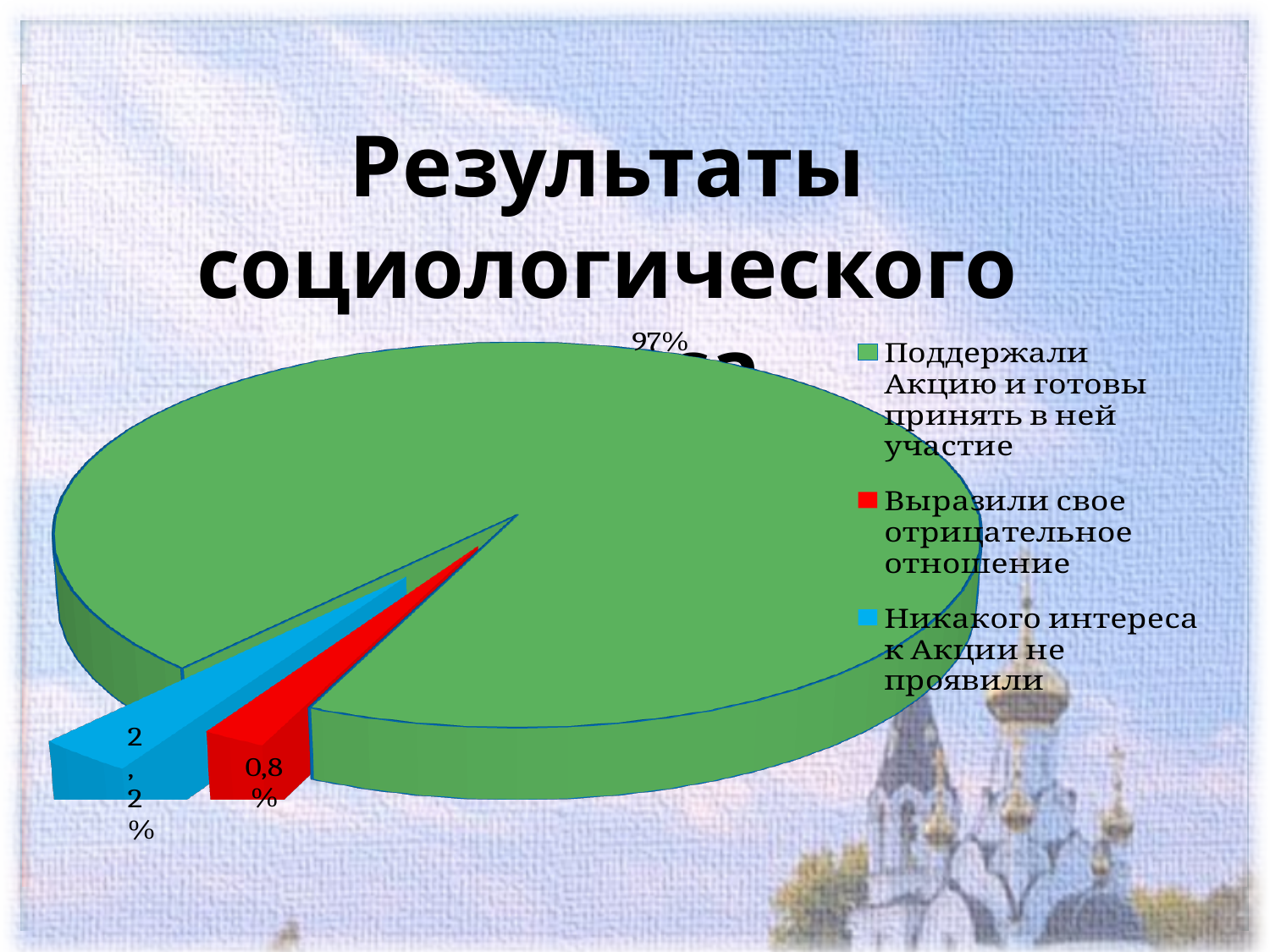
Which category has the largest share of the pie? Поддержали Акцию и готовы принять в ней участие What percentage of respondents supported the Action and are ready to take part in it (Поддержали Акцию и готовы принять в ней участие)? 97% What is the difference in percentage points between the largest slice (97%) and the slice for those who showed no interest (2,2%)? 94,8% How many entries does the legend list? 3 What percentage of respondents expressed a negative attitude (Выразили свое отрицательное отношение)? 0,8% Which is larger: the share of those who showed no interest or the share of those who expressed a negative attitude? Никакого интереса к Акции не проявили What percentage of respondents showed no interest in the Action (Никакого интереса к Акции не проявили)? 2,2% How many slices does the pie chart have? 3 What colour is the slice for those who expressed a negative attitude (Выразили свое отрицательное отношение)? Red Which category has the smallest share of the pie? Выразили свое отрицательное отношение What is the difference in percentage points between the share of those who showed no interest (2,2%) and those who expressed a negative attitude (0,8%)? 1,4% What type of chart is shown on the slide? Pie chart